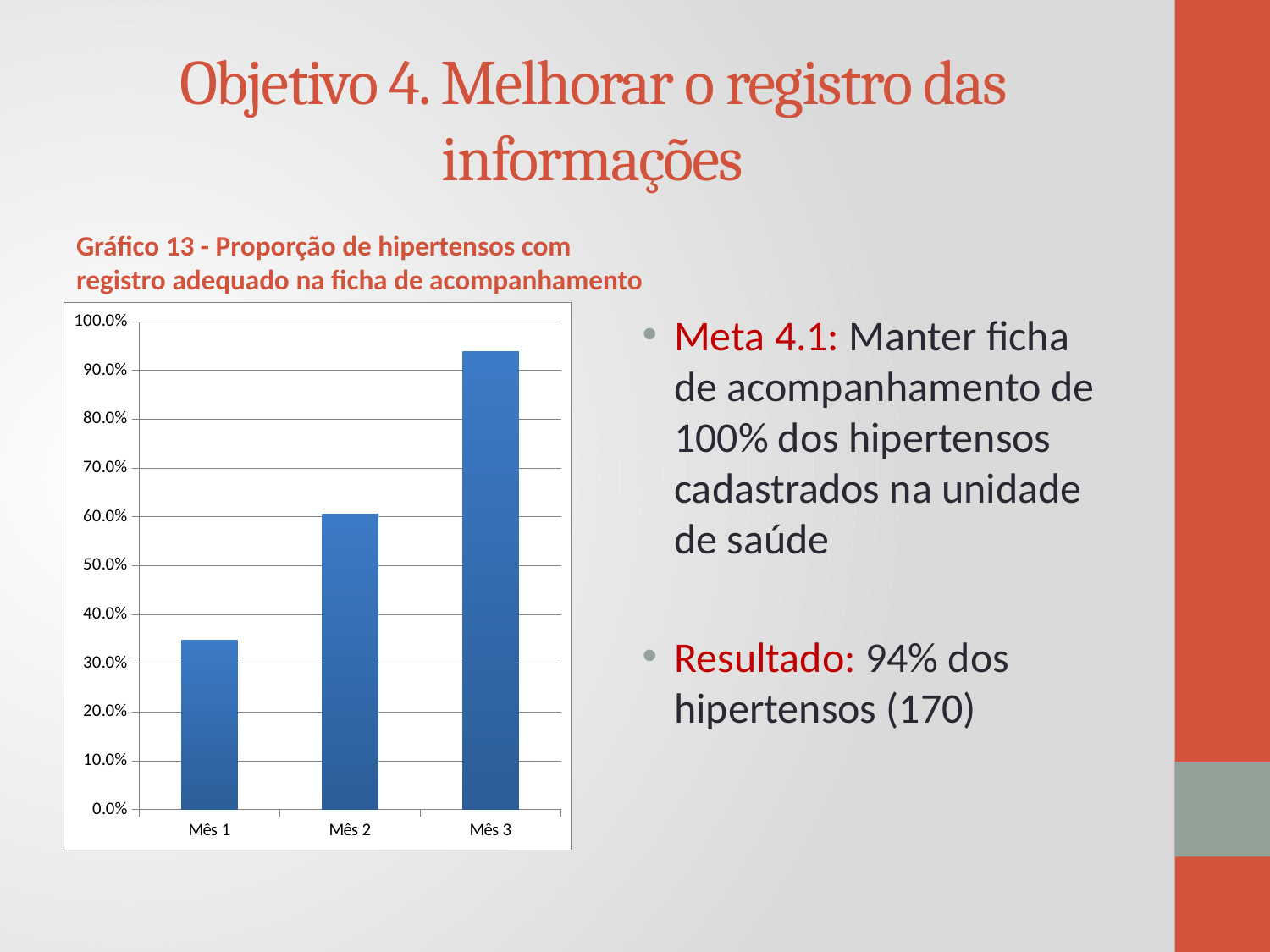
Is the value for Mês 1 greater or less than 40.0%? less Do the values rise or fall from Mês 1 to Mês 3? rise What is the title of the chart on the slide? Gráfico 13 - Proporção de hipertensos com registro adequado na ficha de acompanhamento Which month has the highest bar in the chart? Mês 3 How many categories are plotted on the x axis of the chart? 3 Is the value for Mês 1 greater or less than 30.0%? greater What is the highest value shown on the y axis of the chart? 100.0% What kind of chart is shown on the slide? bar chart Which month has the lowest bar in the chart? Mês 1 Is the value for Mês 2 greater or less than 50.0%? greater Which is larger, the value for Mês 2 or the value for Mês 3? Mês 3